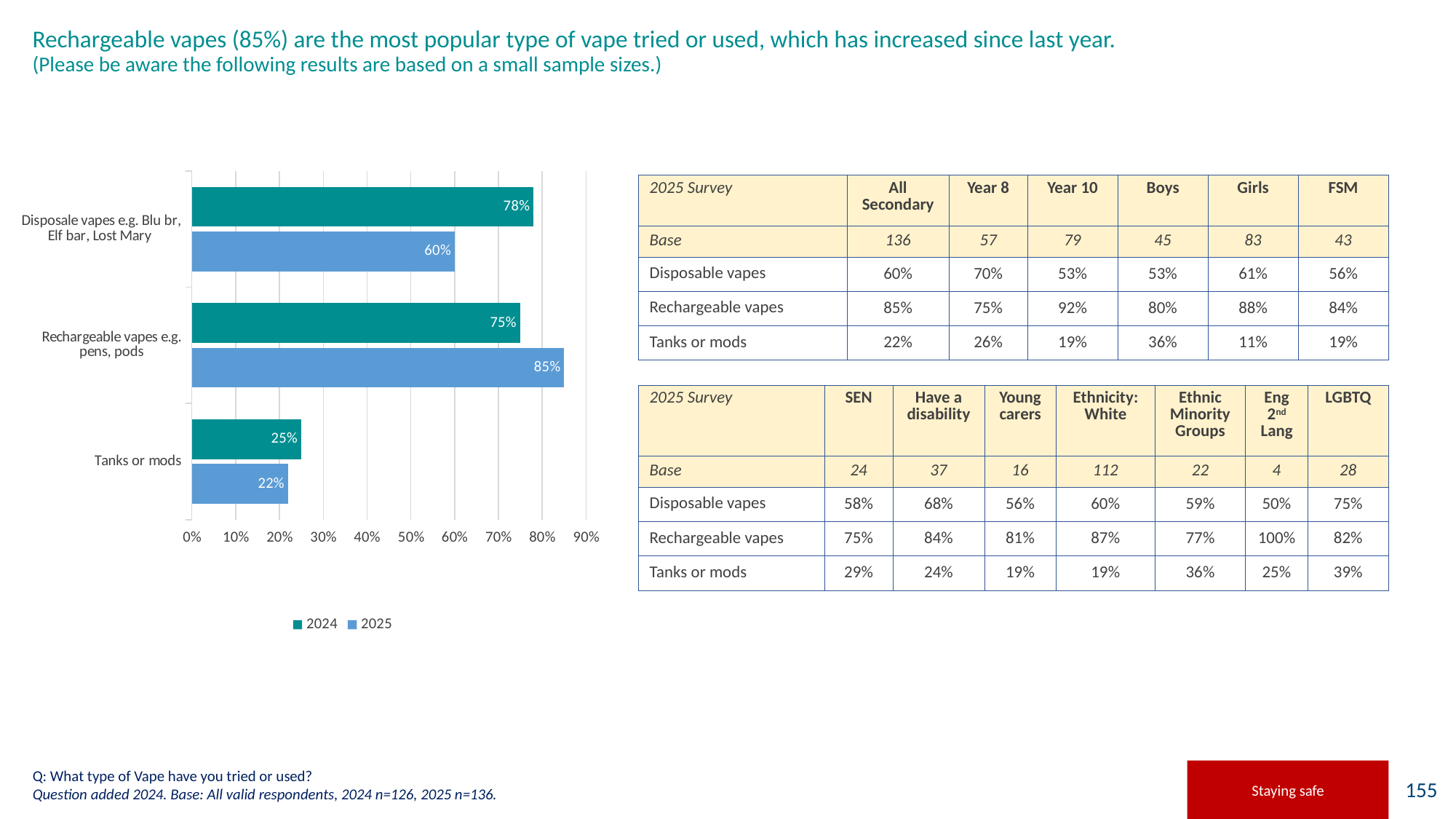
Is the 2024 value for Rechargeable vapes e.g. pens, pods greater or less than 70%? greater What is the 2024 value for Disposale vapes e.g. Blu br, Elf bar, Lost Mary? 78% How many categories are shown on the chart? 3 Which is larger for Tanks or mods, the 2024 value or the 2025 value? 2024 What is the difference between the 2024 and 2025 values for Disposale vapes e.g. Blu br, Elf bar, Lost Mary? 18% What is the 2025 value for Rechargeable vapes e.g. pens, pods? 85% What is the difference between the 2025 and 2024 values for Rechargeable vapes e.g. pens, pods? 10% What is the 2025 value for Tanks or mods? 22% Which category has the lowest 2024 value? Tanks or mods How many series does the legend list? 2 Which category has the highest 2025 value? Rechargeable vapes e.g. pens, pods What kind of chart is shown on the slide? Bar chart